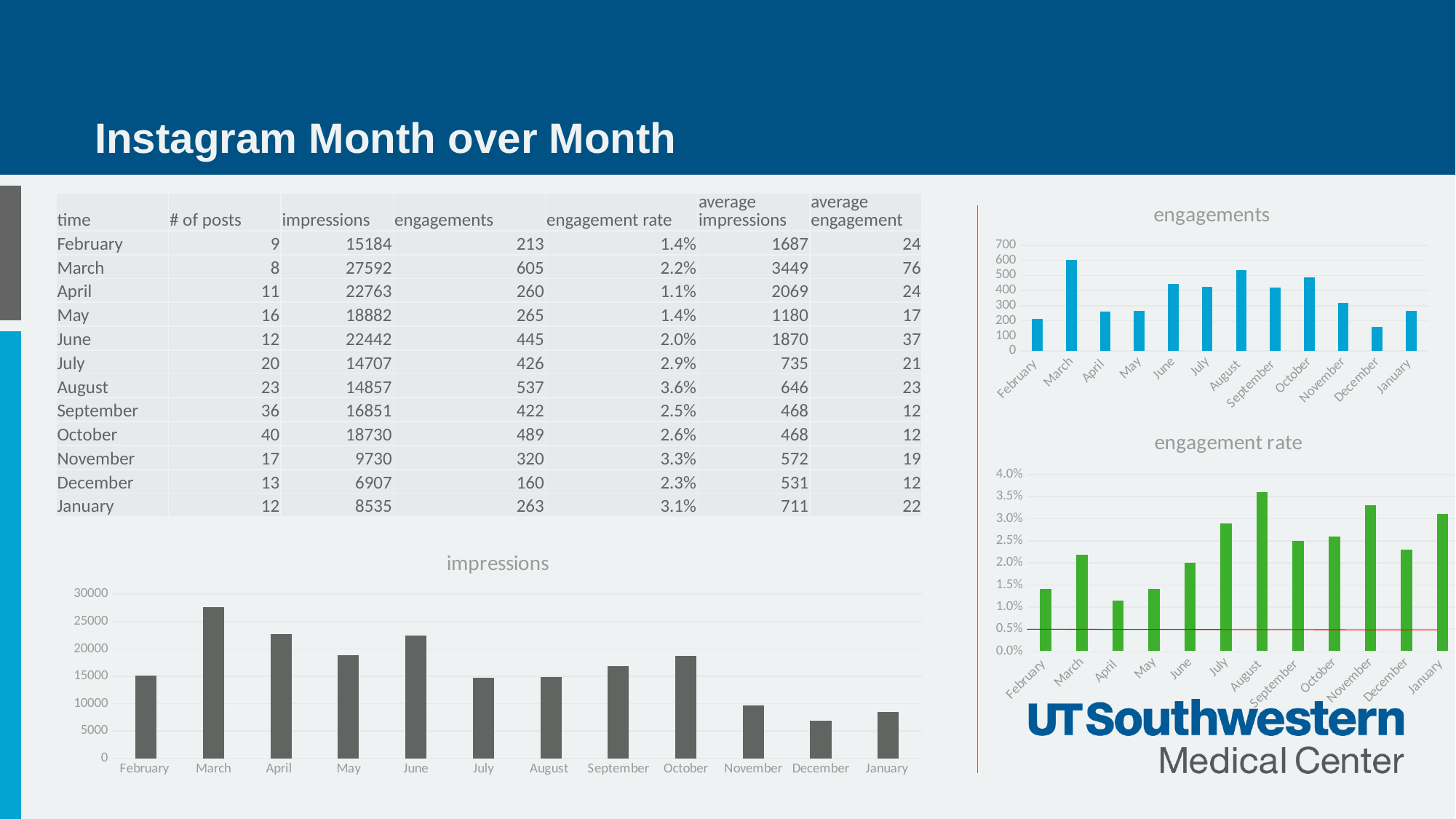
In the "engagement rate" chart, which month has the highest value? August In the "engagement rate" chart, which month has the lowest value? April In the "impressions" chart, which month has the lowest value? December What kind of chart is the "impressions" chart? bar chart In the "engagements" chart, which month has the highest value? March In the "impressions" chart, which month has the highest value? March In the "engagements" chart, is the value for August greater or less than 500? greater What colour are the bars in the "engagement rate" chart? green In the "engagements" chart, which month has the lowest value? December How many months are shown on the x axis of the "impressions" chart? 12 In the "engagement rate" chart, which is larger, the value for July or the value for September? July In the "impressions" chart, is the value for November greater or less than 10000? less